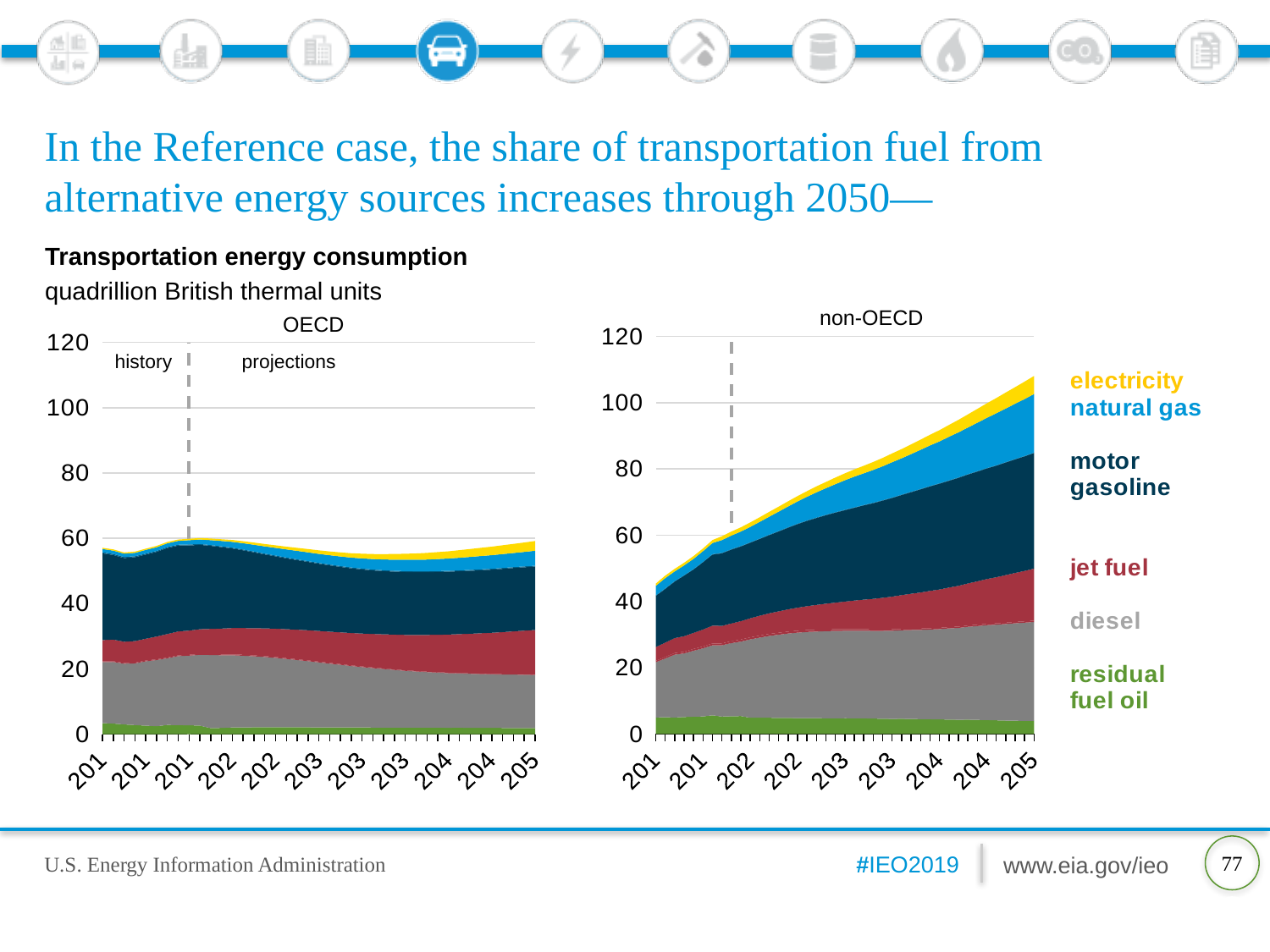
At the right end of the charts, which region has the larger total transportation energy consumption, OECD or non-OECD? non-OECD In the non-OECD chart, is the consumption of natural gas at the right end greater or less than that of electricity? greater In the non-OECD chart, is the total consumption at the right end of the chart greater or less than 100? greater In the non-OECD chart, is the total consumption at the left end of the chart greater or less than 60? less In the non-OECD chart, which fuel has the largest consumption at the right end of the chart? motor gasoline How many fuel series does the legend list? 6 What unit is transportation energy consumption measured in on these charts? quadrillion British thermal units In the OECD chart, is the total consumption at the right end of the chart greater or less than 80? less What kind of chart is the OECD chart? stacked area chart What does the vertical dashed line in each chart separate? history and projections In the non-OECD chart, does total transportation energy consumption rise or fall from left to right? rise In the OECD chart, which fuel has the smallest consumption at the right end of the chart? residual fuel oil